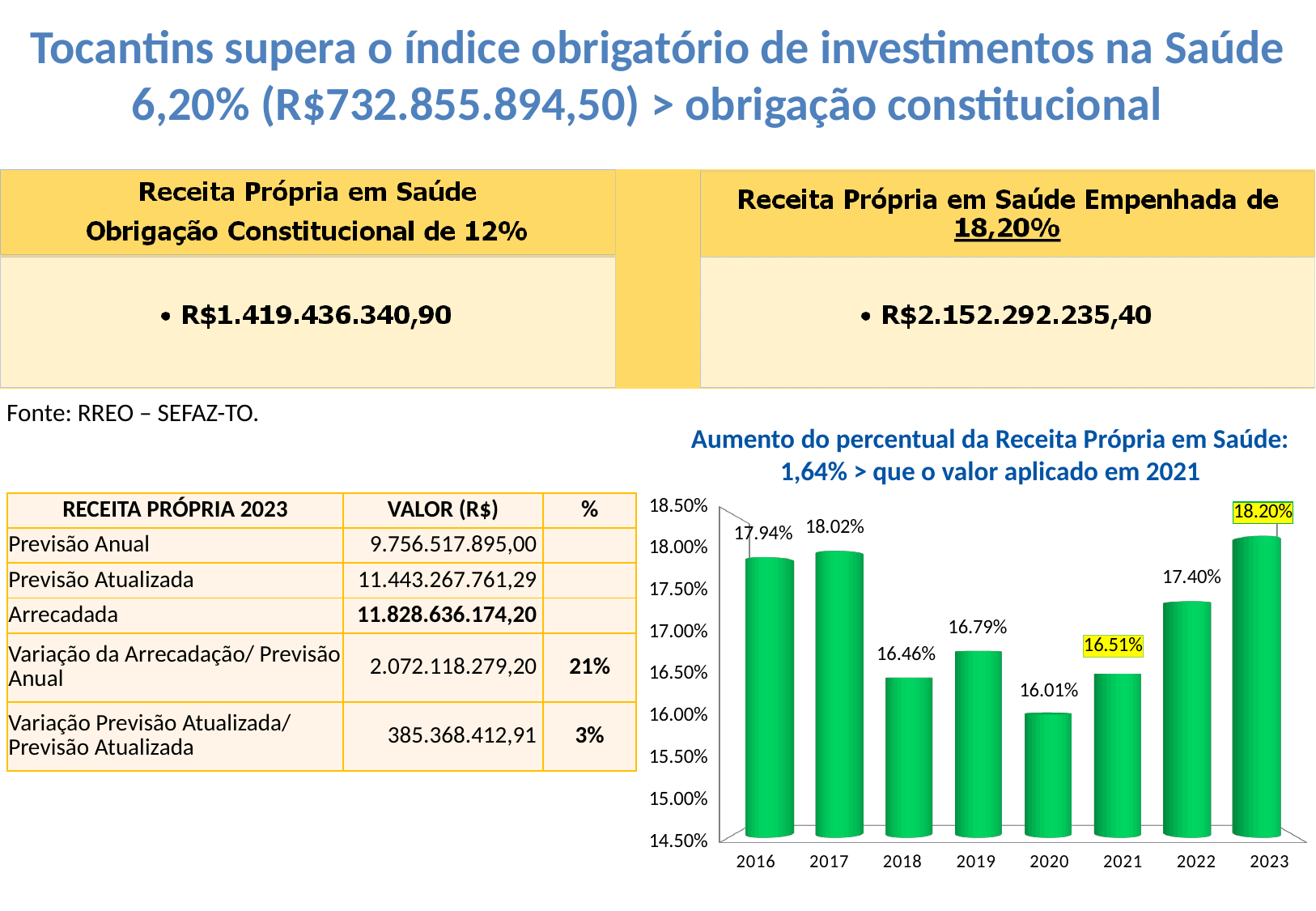
What is the value for 2018 in the chart? 16.46% What is the title of the chart? Aumento do percentual da Receita Própria em Saúde: 1,64% > que o valor aplicado em 2021 Which is larger in the chart, the value for 2019 or the value for 2022? 2022 What is the difference between the values for 2017 and 2016 in the chart? 0.08% What is the value for 2023 in the chart? 18.20% Is the value for 2021 in the chart greater or less than 17.00%? less Which year has the highest value in the chart? 2023 What is the value for 2020 in the chart? 16.01% What kind of chart is shown on the slide? bar chart Which year has the lowest value in the chart? 2020 What is the difference between the values for 2023 and 2021 in the chart? 1.69% How many years are shown on the x axis of the chart? 8